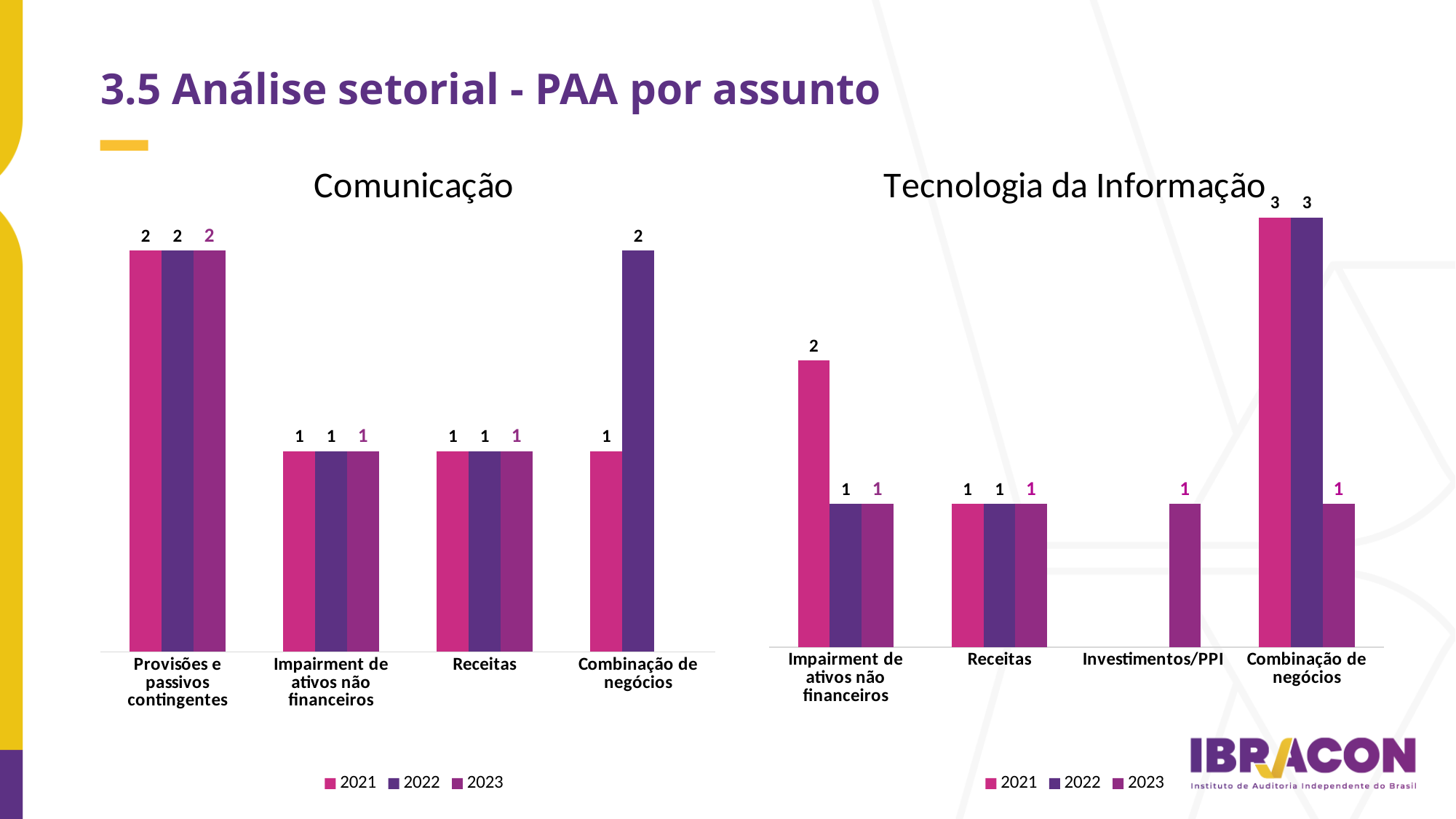
How many categories are shown on the x axis of the Comunicação chart? 4 How many series does the legend of the Tecnologia da Informação chart list? 3 In the Comunicação chart, what is the 2022 value for Combinação de negócios? 2 In the Tecnologia da Informação chart, what is the difference between the 2021 and 2022 values for Impairment de ativos não financeiros? 1 In the Comunicação chart, what is the difference between the 2022 and 2021 values for Combinação de negócios? 1 In the Comunicação chart, what is the 2021 value for Provisões e passivos contingentes? 2 In the Comunicação chart, what is the 2023 value for Receitas? 1 In the Tecnologia da Informação chart, what is the 2021 value for Combinação de negócios? 3 What type of chart is the Comunicação chart? Bar chart In the Tecnologia da Informação chart, which category has the highest 2022 value? Combinação de negócios In the Tecnologia da Informação chart, which is larger for Combinação de negócios: the 2021 value or the 2023 value? 2021 In the Tecnologia da Informação chart, what is the 2021 value for Impairment de ativos não financeiros? 2